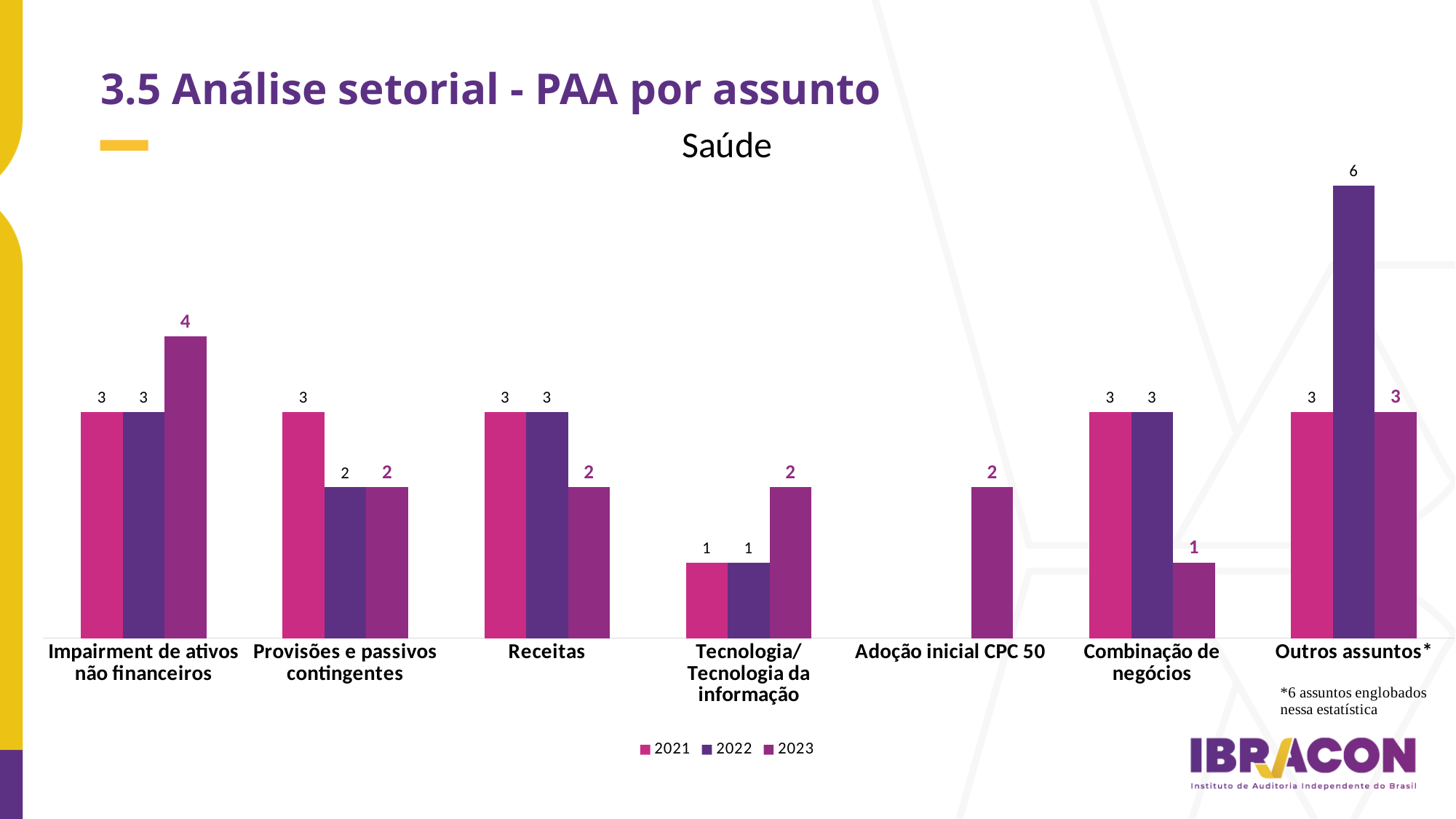
How many series does the legend list? 3 What is the difference between the 2022 and 2023 values in the Outros assuntos* category? 3 What is the value for 2023 in the Impairment de ativos não financeiros category? 4 What is the value for 2022 in the Outros assuntos* category? 6 What is the value for 2023 in the Combinação de negócios category? 1 What is the value for 2021 in the Tecnologia/Tecnologia da informação category? 1 Which category has the lowest value for the 2021 series? Tecnologia/Tecnologia da informação Which category has the highest value for the 2022 series? Outros assuntos* Which is larger in the Receitas category: the 2021 value or the 2023 value? 2021 What is the title of the chart? Saúde How many categories are shown on the x axis? 7 What kind of chart is shown on the slide? Bar chart